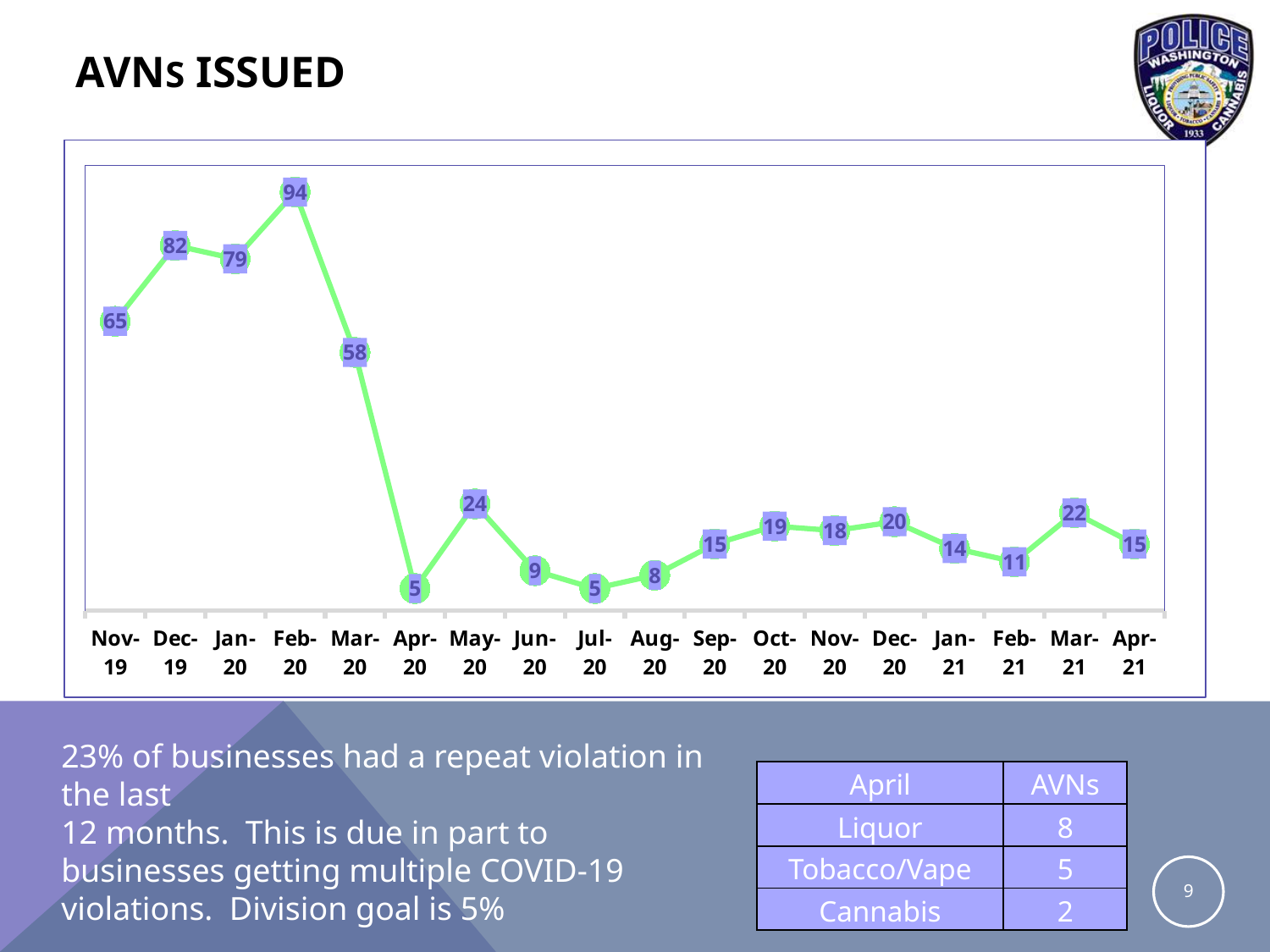
How many AVNs were issued in Feb-20? 94 Which is larger, the value for May-20 or the value for Dec-20? May-20 Which month has the highest number of AVNs issued? Feb-20 What is the value for Apr-21? 15 How many months are plotted on the chart? 18 Do the values rise or fall from Feb-20 to Apr-20? fall What is the difference between the values for Dec-19 and Jan-20? 3 What type of chart is shown on the slide? line chart What is the value for Mar-21? 22 Which is larger, the value for Jan-21 or the value for Feb-21? Jan-21 How many AVNs were issued in Nov-19? 65 What is the difference between the values for Feb-20 and Mar-20? 36